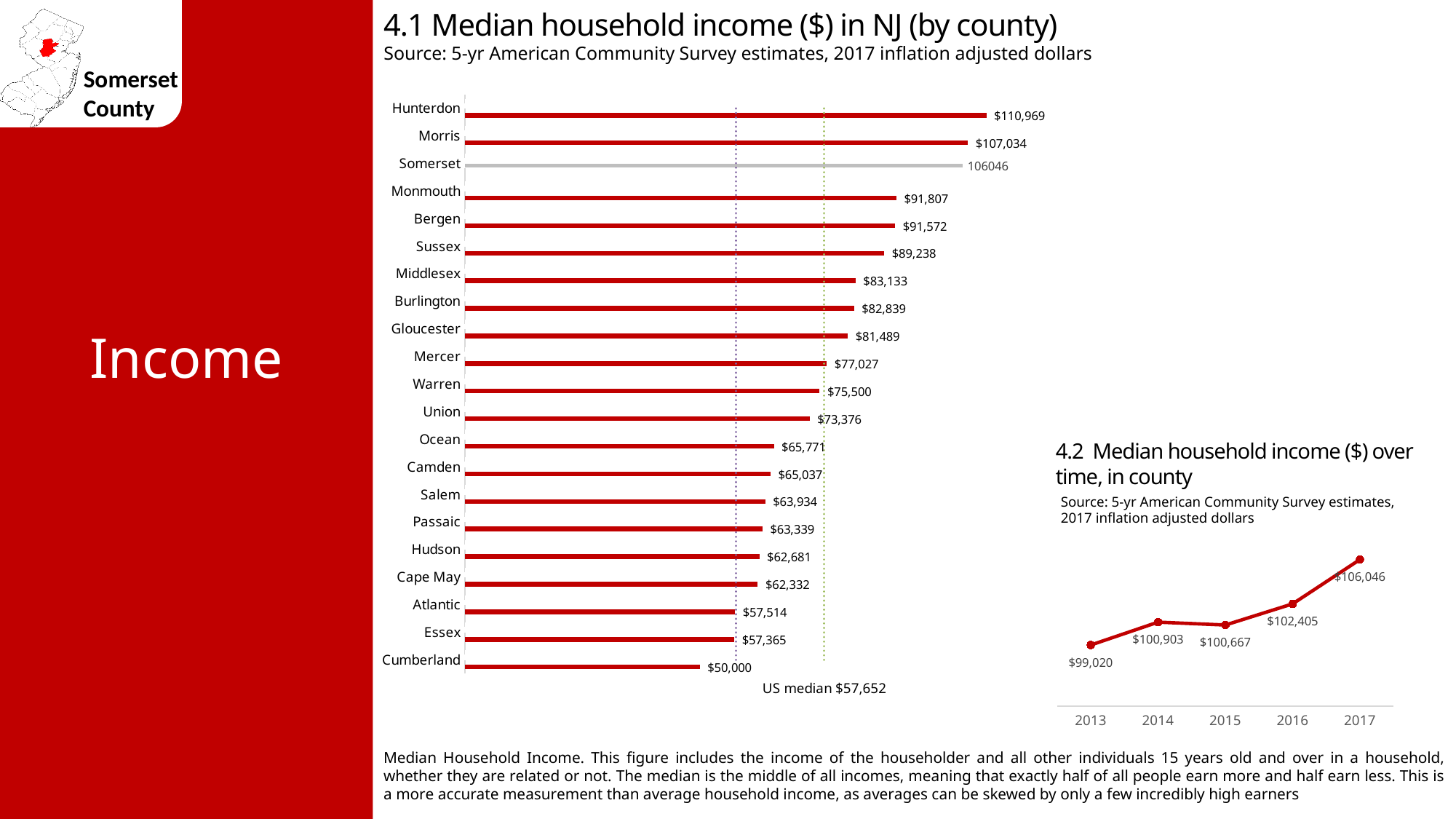
In chart 4.1 Median household income ($) in NJ (by county), what is the median household income for Hunterdon? $110,969 In chart 4.1 Median household income ($) in NJ (by county), which county has a higher median household income, Middlesex or Mercer? Middlesex In chart 4.1 Median household income ($) in NJ (by county), which county has the highest median household income? Hunterdon In chart 4.1 Median household income ($) in NJ (by county), which county has the lowest median household income? Cumberland In chart 4.2 Median household income ($) over time, in county, what is the difference between the 2017 and 2013 values? $7,026 In chart 4.1 Median household income ($) in NJ (by county), what is the difference between Hunterdon's and Morris's median household income? $3,935 In chart 4.1 Median household income ($) in NJ (by county), what is the median household income for Somerset? 106046 In chart 4.1 Median household income ($) in NJ (by county), how many counties are shown? 21 In chart 4.1 Median household income ($) in NJ (by county), what US median value is noted below the bars? $57,652 In chart 4.2 Median household income ($) over time, in county, does the median household income generally rise or fall from 2013 to 2017? Rise In chart 4.2 Median household income ($) over time, in county, what was the median household income in 2015? $100,667 What kind of chart is chart 4.1 Median household income ($) in NJ (by county)? Bar chart